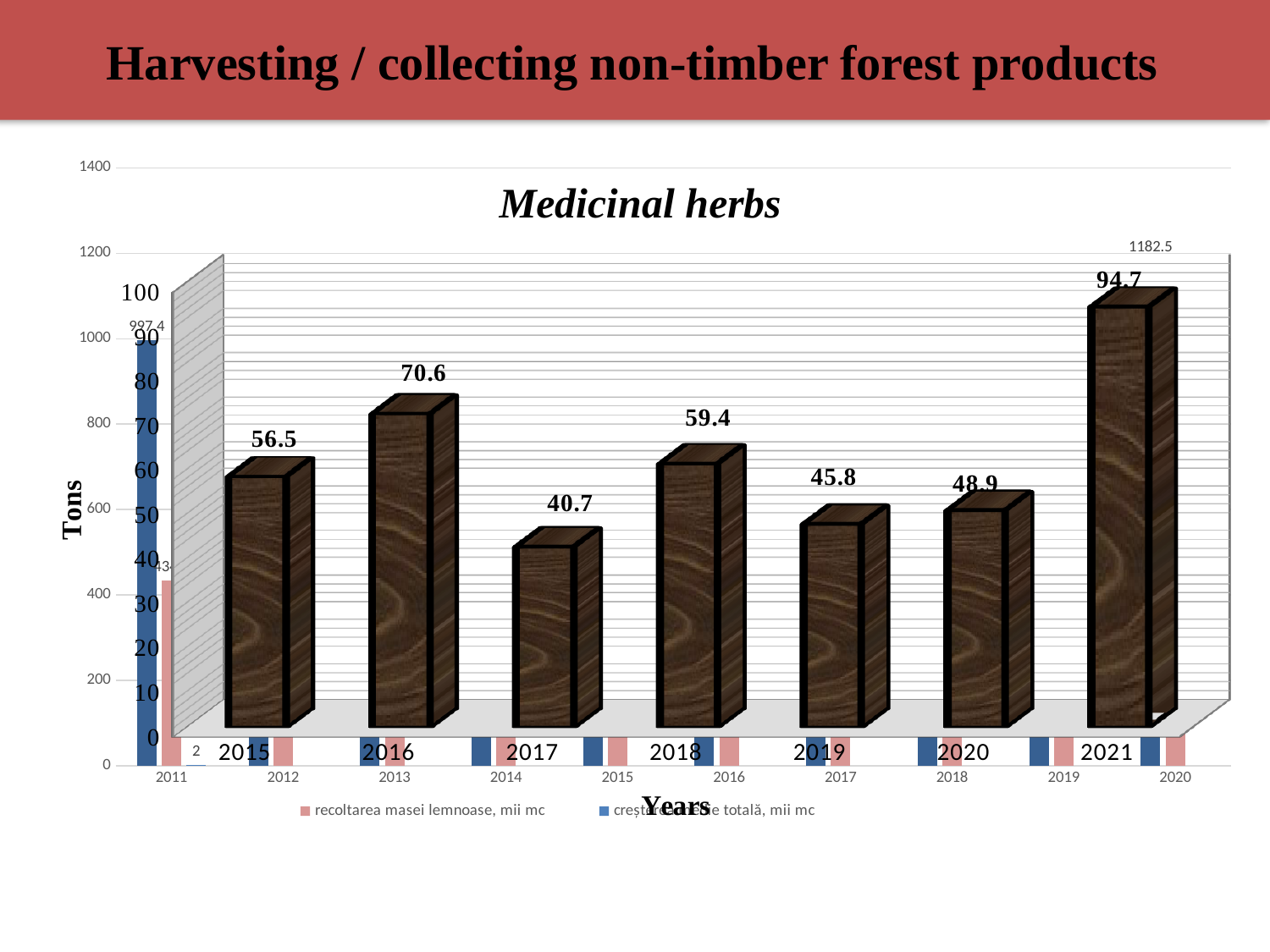
In the Medicinal herbs chart, what is the value for 2021? 94.7 In the Medicinal herbs chart, which year has the larger value, 2018 or 2019? 2018 In the Medicinal herbs chart, what is the value for 2017? 40.7 What kind of chart is the Medicinal herbs chart? bar chart In the Medicinal herbs chart, which year has the lowest value? 2017 In the Medicinal herbs chart, what is the difference between the values for 2021 and 2017? 54 In the Medicinal herbs chart, which year has the highest value? 2021 How many years are shown in the Medicinal herbs chart? 7 What is the vertical axis title of the Medicinal herbs chart? Tons In the Medicinal herbs chart, what is the difference between the values for 2016 and 2015? 14.1 In the Medicinal herbs chart, does the value rise or fall from 2015 to 2016? rise In the Medicinal herbs chart, what is the value for 2020? 48.9